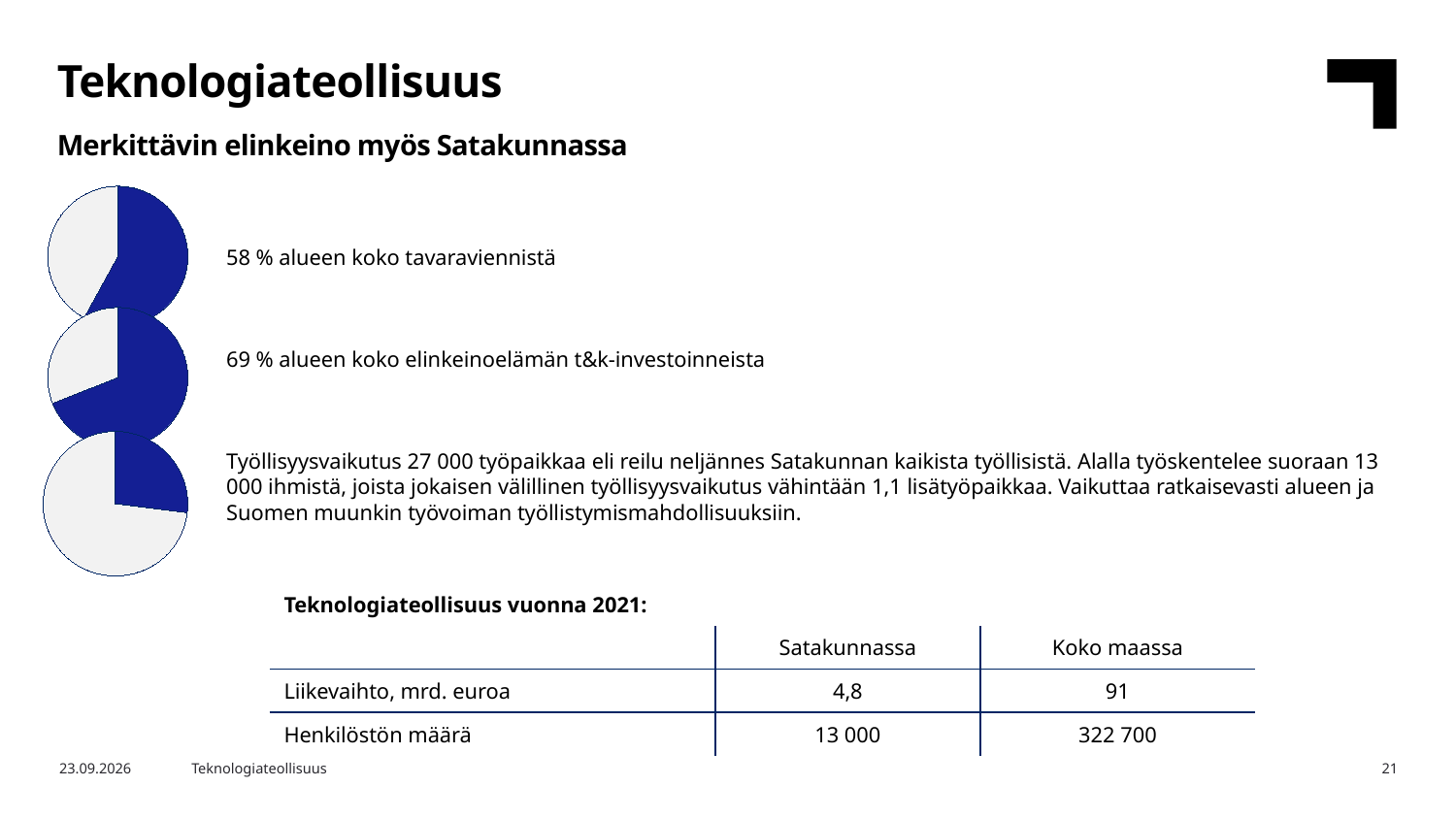
What kind of charts are shown on the left side of the slide? Pie charts According to the text next to the top pie chart, what share of the region's total goods exports does the highlighted slice represent? 58 % How many slices does each pie chart have? 2 According to the text next to the middle pie chart, what share of the region's business R&D investments does the highlighted slice represent? 69 % What colour is used for the highlighted slice in the pie charts? Blue Is the blue slice in the middle pie chart larger or smaller than the blue slice in the top pie chart? larger Which of the three pie charts has the smallest highlighted (blue) slice? The bottom pie chart Which of the three pie charts has the largest highlighted (blue) slice? The middle pie chart Is the blue slice in the middle pie chart greater or less than half of the pie? greater What is the difference in percentage points between the shares stated for the middle pie chart (69 %) and the top pie chart (58 %)? 11 percentage points Is the blue slice in the bottom pie chart greater or less than half of the pie? less How many pie charts are on the slide? 3